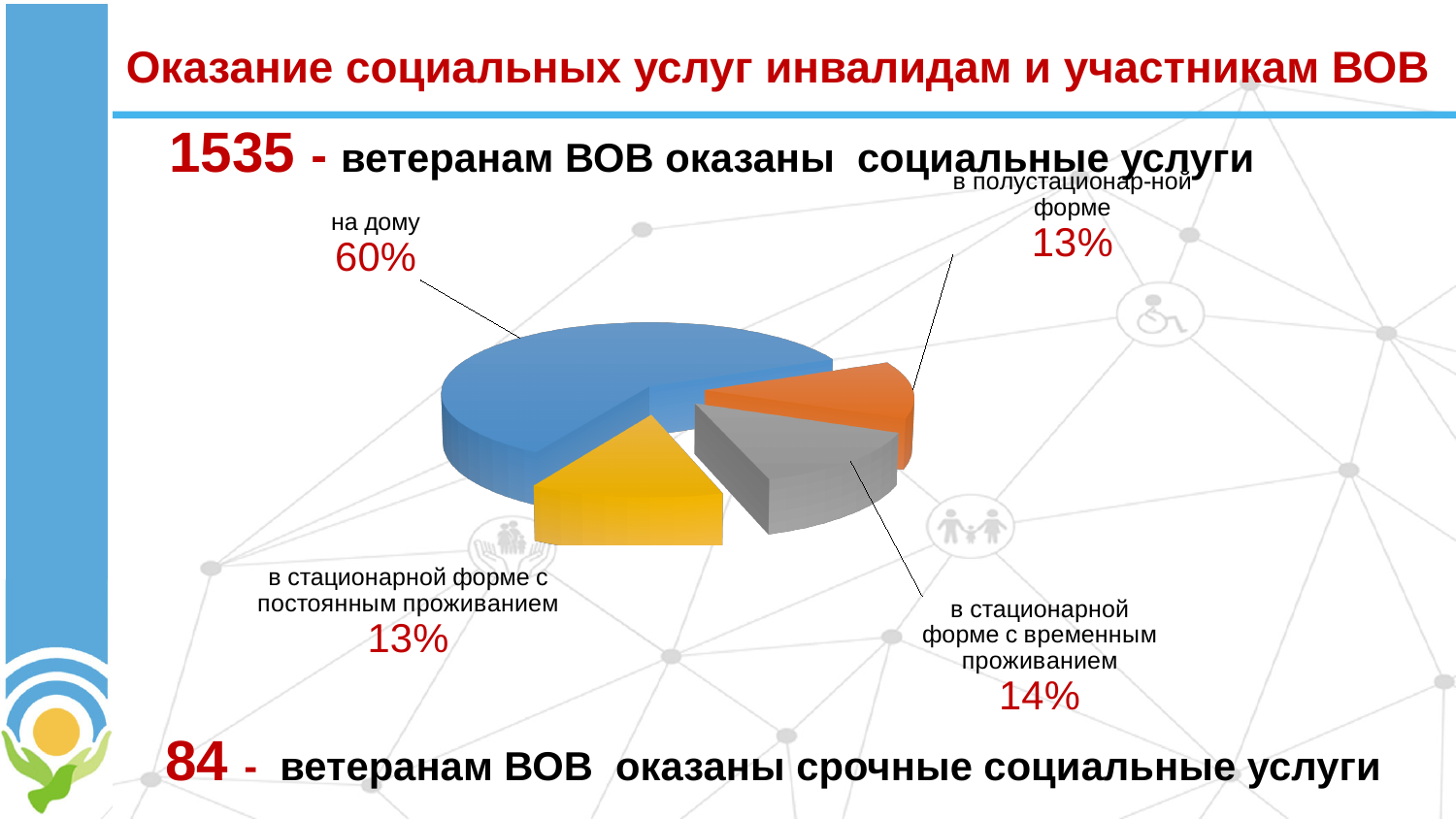
What percentage is shown for "в полустационарной форме"? 13% Is the share for "в стационарной форме с временным проживанием" greater or less than 50%? less What percentage is shown for "в стационарной форме с временным проживанием"? 14% What share of the pie chart is labelled "на дому"? 60% By how many percentage points does the "на дому" share exceed the "в стационарной форме с временным проживанием" share? 46 percentage points What percentage is shown for "в стационарной форме с постоянным проживанием"? 13% What type of chart is shown on the slide? Pie chart Which is larger: the share for "на дому" or the share for "в стационарной форме с временным проживанием"? на дому How many slices does the pie chart have? 4 Which category is represented by the orange slice? в полустационарной форме What colour is the "на дому" slice of the pie chart? Blue Which category has the largest share of the pie chart? на дому